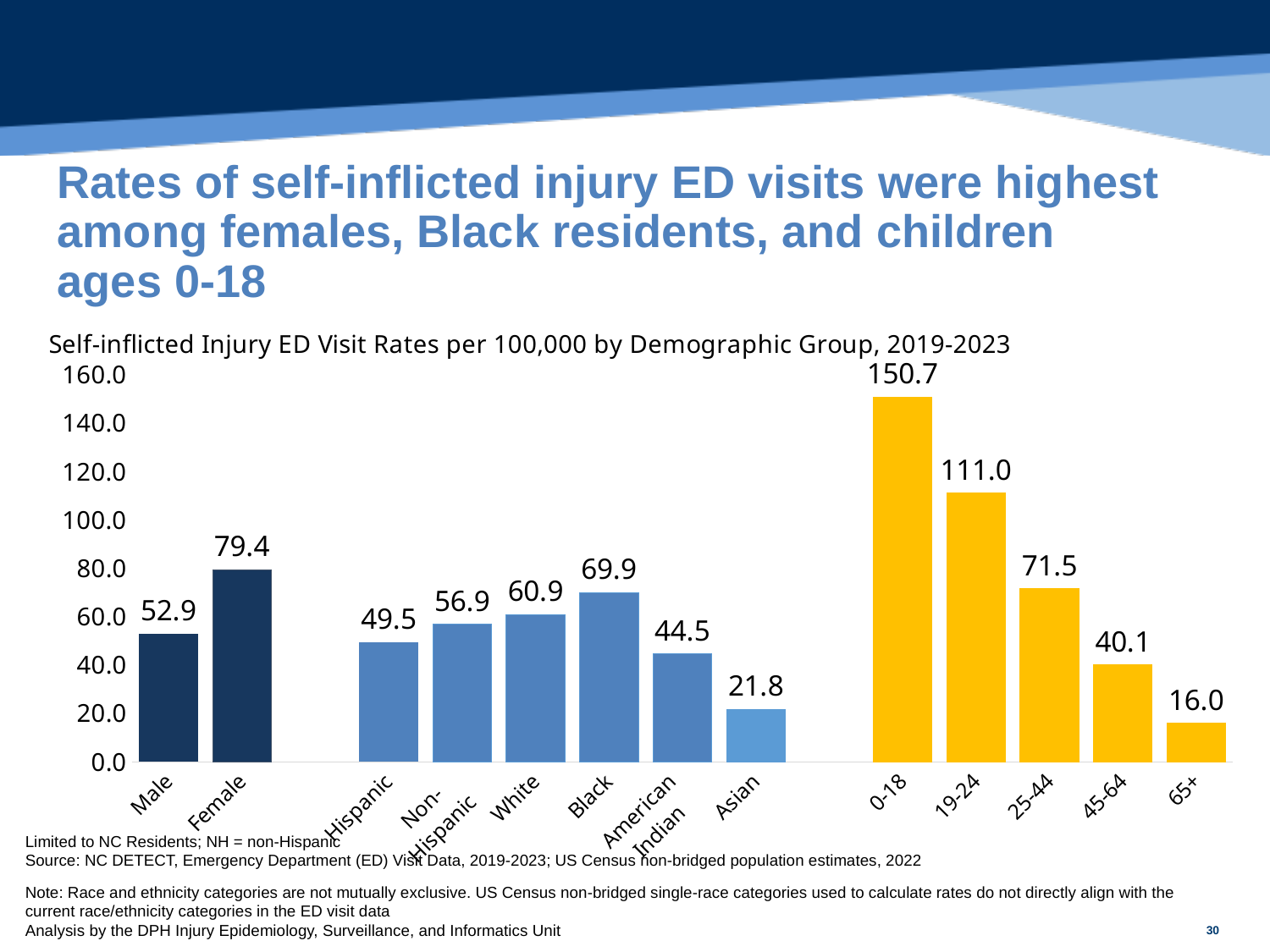
What is the difference between the Female and Male self-inflicted injury ED visit rates? 26.5 How many demographic groups are shown on the chart? 13 What type of chart is shown on the slide? Bar chart What is the self-inflicted injury ED visit rate per 100,000 for Female? 79.4 What is the difference between the 0-18 and 19-24 self-inflicted injury ED visit rates? 39.7 Do the self-inflicted injury ED visit rates rise or fall across the age groups from 0-18 to 65+? Fall Which demographic group has the lowest self-inflicted injury ED visit rate on the chart? 65+ Which has a higher self-inflicted injury ED visit rate, White or Hispanic? White Which demographic group has the highest self-inflicted injury ED visit rate on the chart? 0-18 What is the self-inflicted injury ED visit rate per 100,000 for the 0-18 age group? 150.7 What is the self-inflicted injury ED visit rate per 100,000 for Black residents? 69.9 What is the self-inflicted injury ED visit rate per 100,000 for the 65+ age group? 16.0